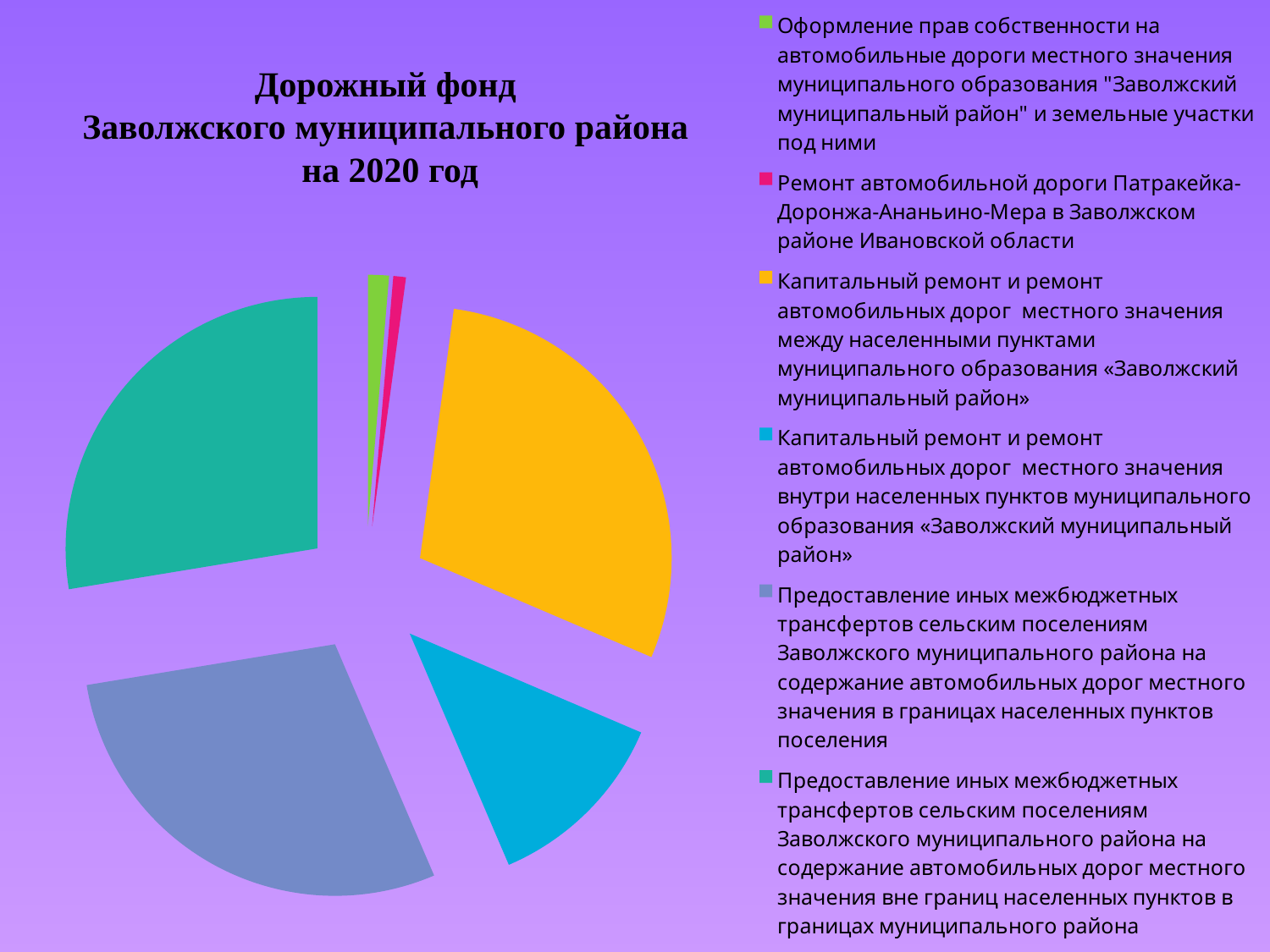
What kind of chart is shown on the slide? pie chart What colour is the slice for "Ремонт автомобильной дороги Патракейка-Доронжа-Ананьино-Мера в Заволжском районе Ивановской области"? pink What is the title of the chart? Дорожный фонд Заволжского муниципального района на 2020 год Which slice is larger: "Ремонт автомобильной дороги Патракейка-Доронжа-Ананьино-Мера в Заволжском районе Ивановской области" or "Предоставление иных межбюджетных трансфертов сельским поселениям ... вне границ населенных пунктов в границах муниципального района"? Предоставление иных межбюджетных трансфертов сельским поселениям ... вне границ населенных пунктов в границах муниципального района Which slice is larger: "Капитальный ремонт и ремонт автомобильных дорог местного значения между населенными пунктами муниципального образования «Заволжский муниципальный район»" or "Капитальный ремонт и ремонт автомобильных дорог местного значения внутри населенных пунктов муниципального образования «Заволжский муниципальный район»"? Капитальный ремонт и ремонт автомобильных дорог местного значения между населенными пунктами муниципального образования «Заволжский муниципальный район» Which slice is larger: "Оформление прав собственности на автомобильные дороги местного значения..." or "Предоставление иных межбюджетных трансфертов сельским поселениям ... в границах населенных пунктов поселения"? Предоставление иных межбюджетных трансфертов сельским поселениям ... в границах населенных пунктов поселения How many categories does the legend of the pie chart list? 6